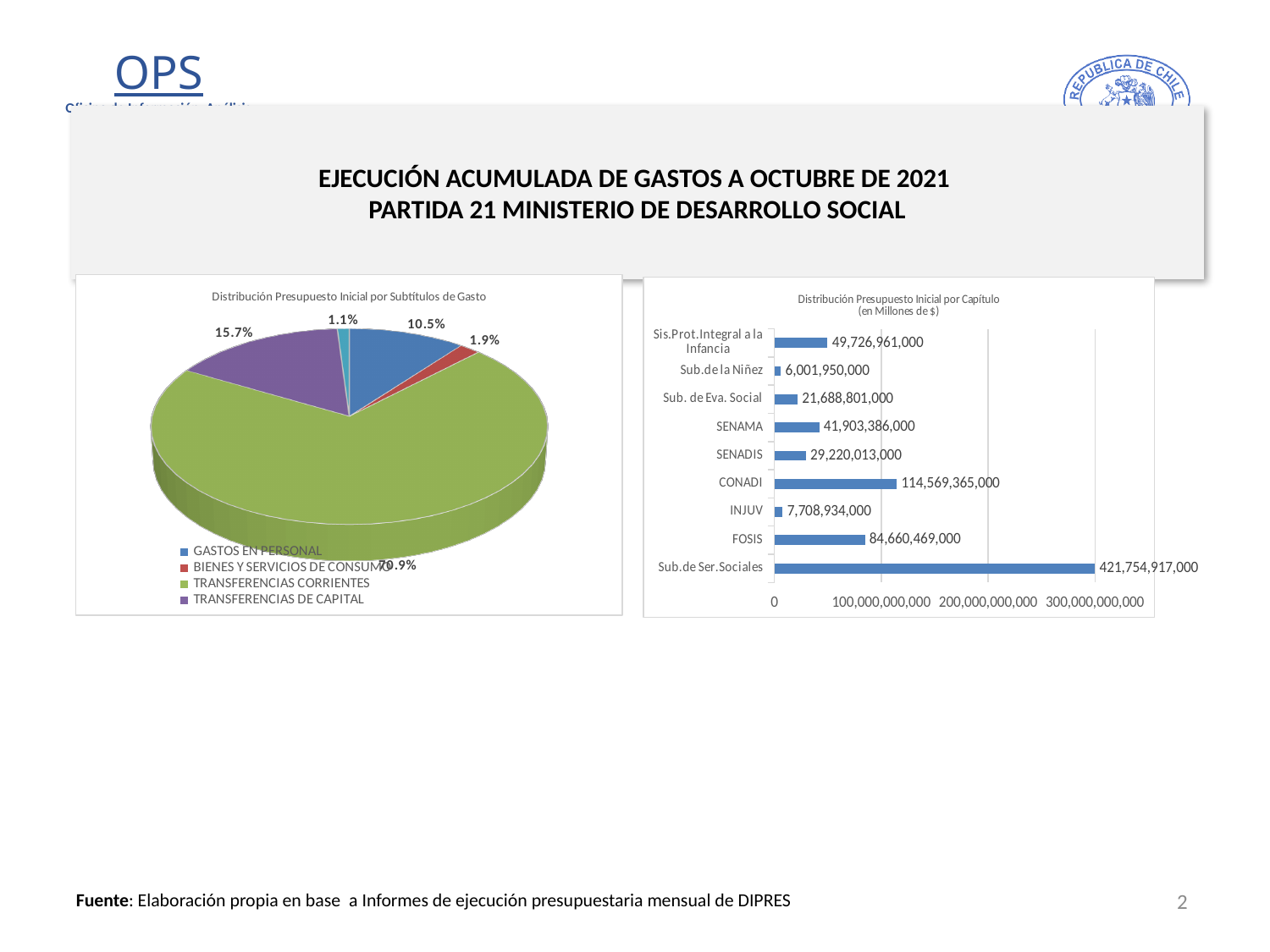
In the pie chart 'Distribución Presupuesto Inicial por Subtítulos de Gasto', how many entries does the legend list? 4 In the bar chart 'Distribución Presupuesto Inicial por Capítulo', what is the value for CONADI? 114,569,365,000 In the bar chart 'Distribución Presupuesto Inicial por Capítulo', which category has the lowest value? Sub.de la Niñez In the pie chart 'Distribución Presupuesto Inicial por Subtítulos de Gasto', what share does TRANSFERENCIAS CORRIENTES have? 70.9% In the pie chart 'Distribución Presupuesto Inicial por Subtítulos de Gasto', which category has the largest slice? TRANSFERENCIAS CORRIENTES In the pie chart 'Distribución Presupuesto Inicial por Subtítulos de Gasto', what share does GASTOS EN PERSONAL have? 10.5% In the bar chart 'Distribución Presupuesto Inicial por Capítulo', which is larger, SENAMA or Sub. de Eva. Social? SENAMA In the bar chart 'Distribución Presupuesto Inicial por Capítulo', what is the value for SENADIS? 29,220,013,000 In the bar chart 'Distribución Presupuesto Inicial por Capítulo', how many categories are shown? 9 In the pie chart 'Distribución Presupuesto Inicial por Subtítulos de Gasto', what share does TRANSFERENCIAS DE CAPITAL have? 15.7% In the bar chart 'Distribución Presupuesto Inicial por Capítulo', what is the difference between FOSIS and INJUV? 76,951,535,000 In the bar chart 'Distribución Presupuesto Inicial por Capítulo', which category has the highest value? Sub.de Ser.Sociales